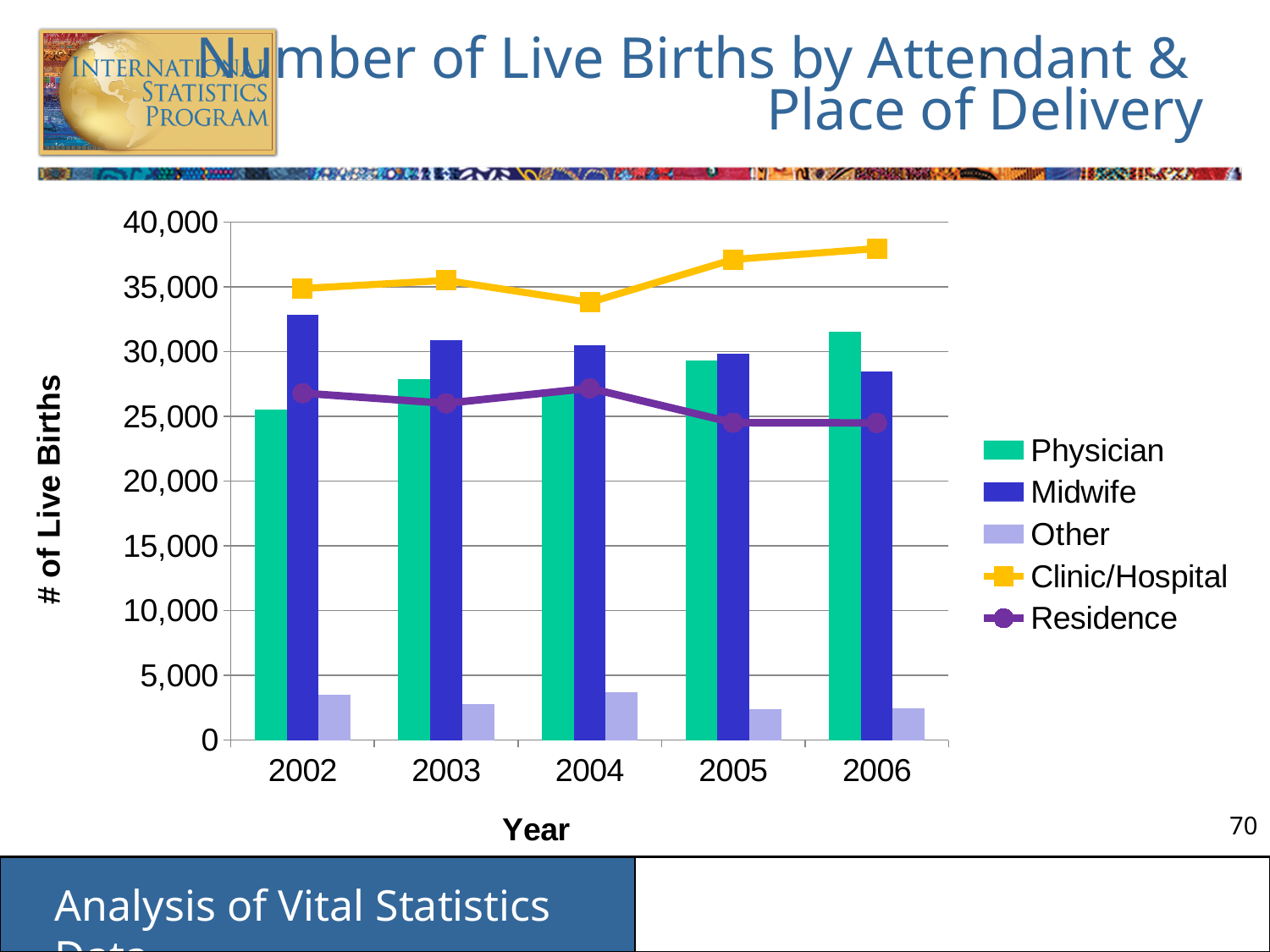
In 2002, which is larger, the Physician bar or the Midwife bar? Midwife Is the Other value for 2004 greater or less than 5,000? less How many series does the legend list? 5 Do the Midwife values rise or fall from 2002 to 2006? fall Is the Physician value for 2002 greater or less than 30,000? less What kind of chart is shown on the slide? bar and line chart How many years are shown on the x axis? 5 In which year is the Midwife bar highest? 2002 In which year is the Midwife bar lowest? 2006 In which year is the Physician bar highest? 2006 What is the title of the y axis? # of Live Births Is the Clinic/Hospital value for 2006 greater or less than 35,000? greater